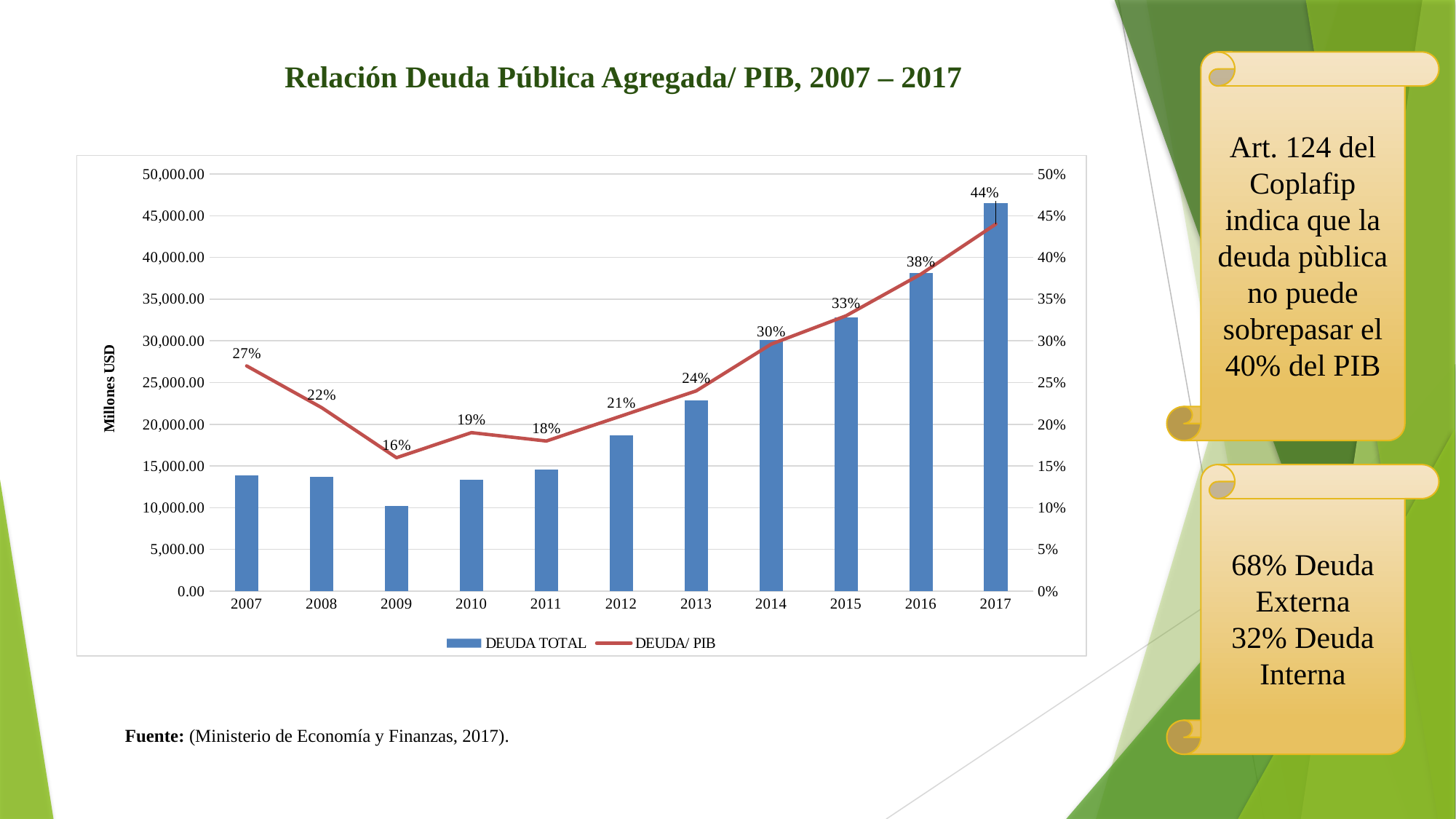
Is the DEUDA TOTAL value for 2009 greater or less than 15,000.00? less What is the DEUDA/ PIB value for 2007? 27% How many years are shown on the x axis? 11 How many series does the legend list? 2 What is the DEUDA/ PIB value for 2012? 21% What is the title of the chart? Relación Deuda Pública Agregada/ PIB, 2007 – 2017 Is the DEUDA TOTAL value for 2017 greater or less than 45,000.00? greater In which year is the DEUDA/ PIB value highest? 2017 What is the difference between the DEUDA/ PIB values for 2017 and 2016? 6% Which year has a higher DEUDA/ PIB value, 2010 or 2011? 2010 In which year is the DEUDA/ PIB value lowest? 2009 What is the DEUDA/ PIB value for 2017? 44%